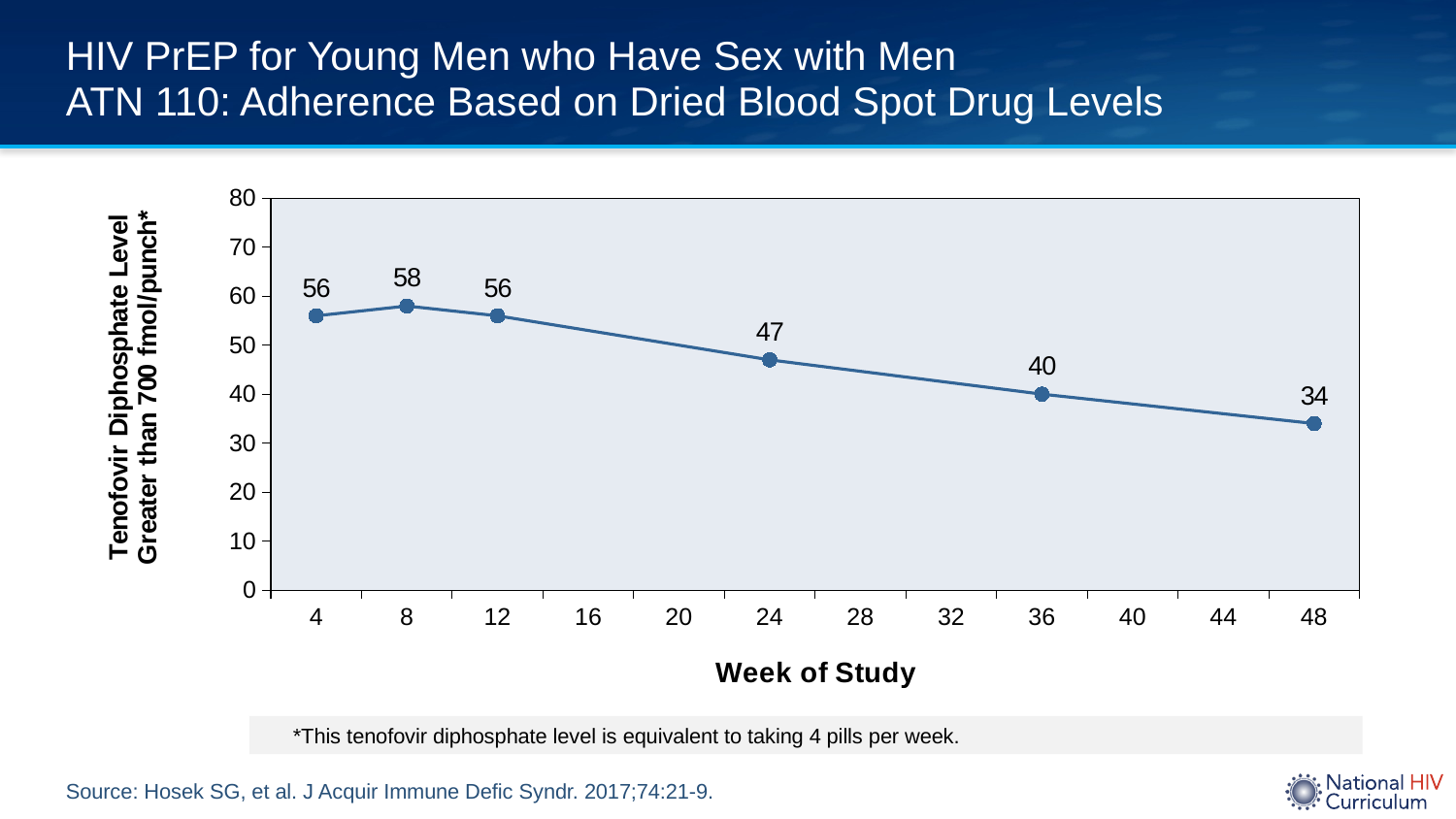
How many data points are plotted on the chart? 6 At which week of study is the value highest? 8 What is the value at week 8? 58 Which is larger, the value at week 24 or the value at week 36? week 24 What is the value at week 36? 40 What is the value at week 48? 34 What is the value at week 24? 47 What kind of chart is shown on the slide? line chart Do the values generally rise or fall from week 8 to week 48? fall At which week of study is the value lowest? 48 Is the value at week 12 greater or less than 50? greater What is the difference between the value at week 8 and the value at week 48? 24